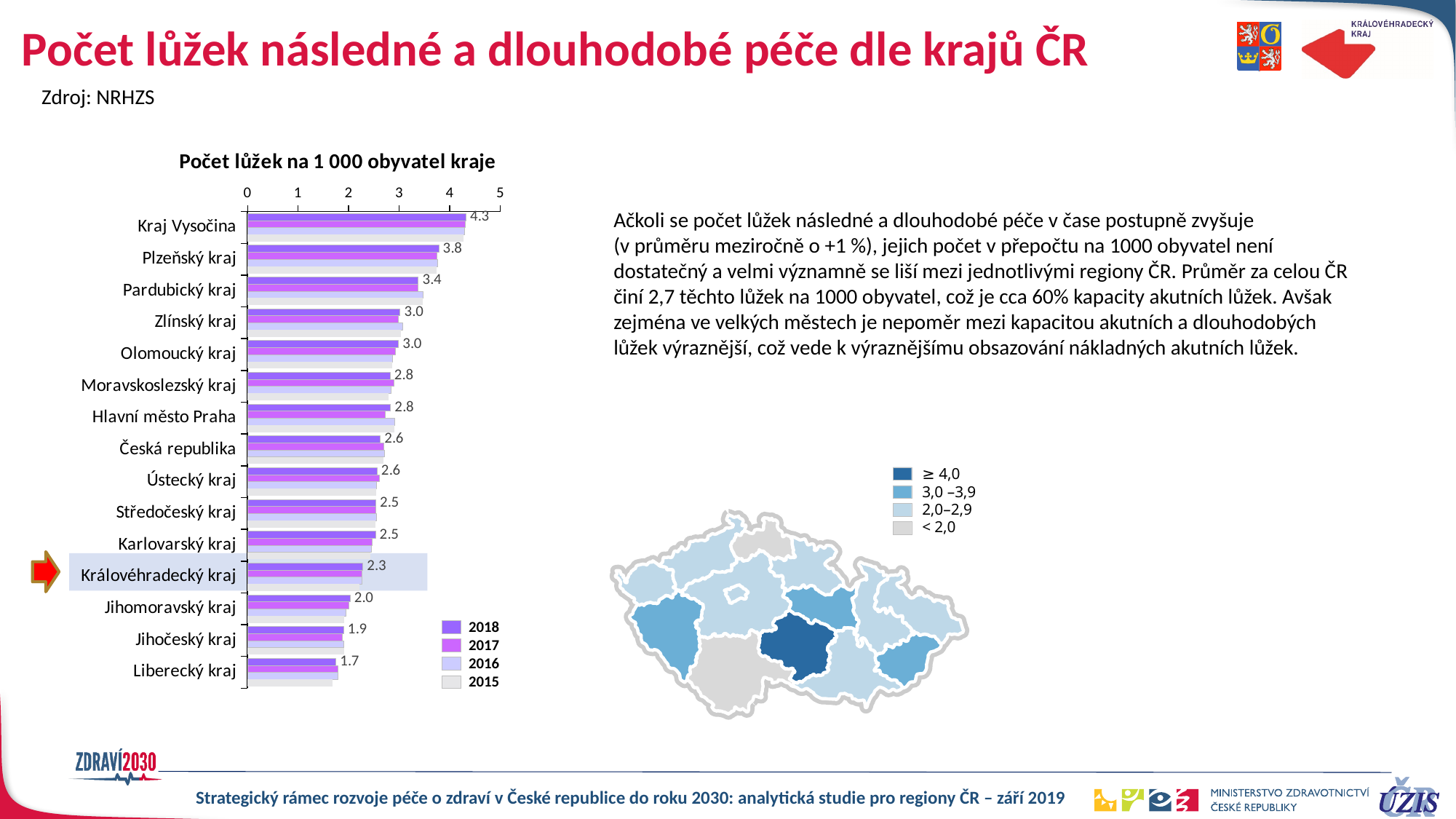
What is the 2018 value for Kraj Vysočina? 4.3 How many series does the chart legend list? 4 What is the 2018 value for Česká republika? 2.6 What type of chart is shown under the title 'Počet lůžek na 1 000 obyvatel kraje'? bar chart How many categories (regions, including Česká republika) are listed on the chart? 15 Which years are listed in the chart legend? 2018, 2017, 2016, 2015 What is the difference between the 2018 values for Kraj Vysočina and Liberecký kraj? 2.6 Is the 2018 value for Jihomoravský kraj greater or less than 3? less Which has a larger 2018 value, Plzeňský kraj or Pardubický kraj? Plzeňský kraj Which region has the highest 2018 value? Kraj Vysočina Which region has the lowest 2018 value? Liberecký kraj What is the 2018 value for Královéhradecký kraj? 2.3